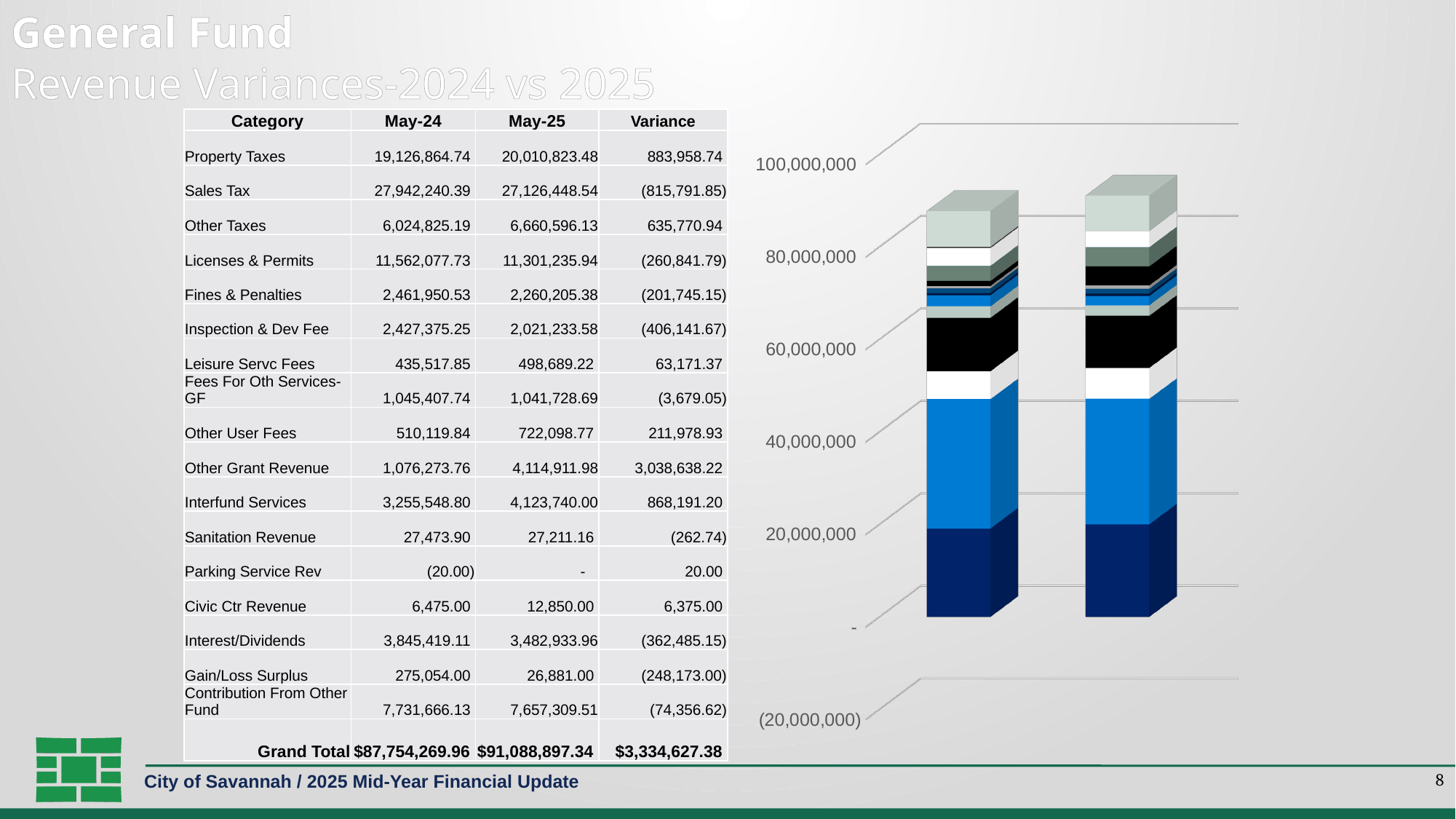
Is the total height of the right stacked bar greater or less than 100,000,000? less Is the total height of the right stacked bar greater or less than 80,000,000? greater How many bars are plotted in the chart on the right side of the slide? 2 In the right bar, is the top of the bright blue segment (the second segment from the bottom) greater or less than 60,000,000? less What is the lowest value labelled on the vertical axis of the chart? (20,000,000) What kind of chart is shown on the right side of the slide? Stacked bar chart Does the chart display a legend identifying the stacked segments? No What is the highest value labelled on the vertical axis of the chart? 100,000,000